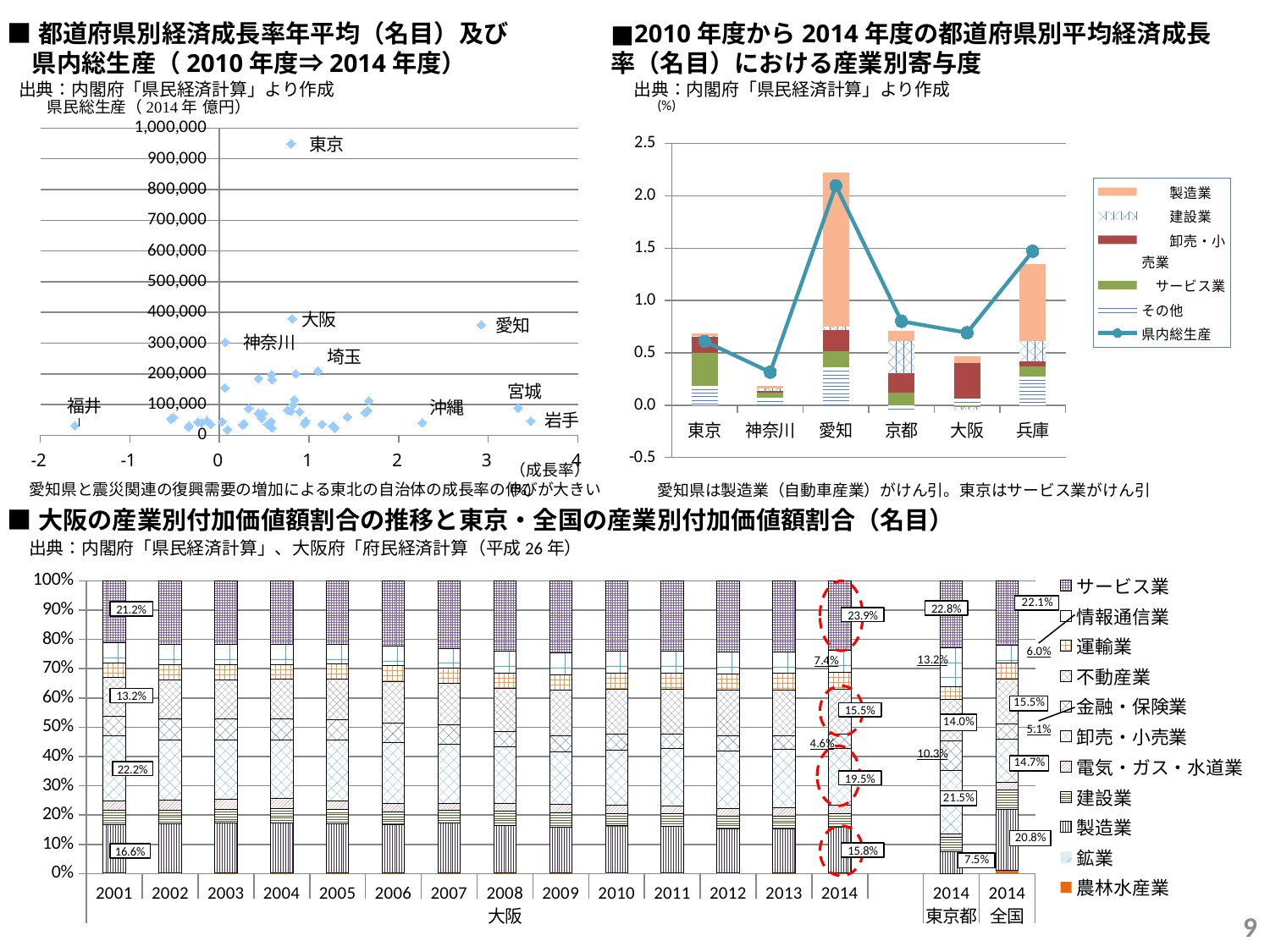
In the top-left chart (都道府県別経済成長率年平均及び県内総生産), which labeled prefecture has the highest 県内総生産? 東京 In the bottom chart (大阪の産業別付加価値額割合の推移), what is the share of 製造業 for 大阪 in 2014? 15.8% In the bottom chart (大阪の産業別付加価値額割合の推移), how many industries does the legend list? 11 In the top-right chart (産業別寄与度), how many entries does the legend list? 6 In the top-left chart (都道府県別経済成長率年平均及び県内総生産), what kind of chart is it? scatter chart In the top-right chart (産業別寄与度), how many prefectures are shown on the x axis? 6 In the bottom chart (大阪の産業別付加価値額割合の推移), what is the difference between the 製造業 share of 大阪 in 2014 (15.8%) and that of 東京都 in 2014 (7.5%)? 8.3 percentage points In the top-right chart (産業別寄与度), which prefecture has the highest 県内総生産 value on the line? 愛知 In the top-left chart (都道府県別経済成長率年平均及び県内総生産), is the 県内総生産 value for 東京 greater or less than 900,000? greater In the top-left chart (都道府県別経済成長率年平均及び県内総生産), is the growth rate (成長率) for 福井 greater or less than -1? less In the bottom chart (大阪の産業別付加価値額割合の推移), what is the share of サービス業 for 東京都 in 2014? 22.8% In the top-right chart (産業別寄与度), is the 県内総生産 line value for 愛知 greater or less than 2.0? greater